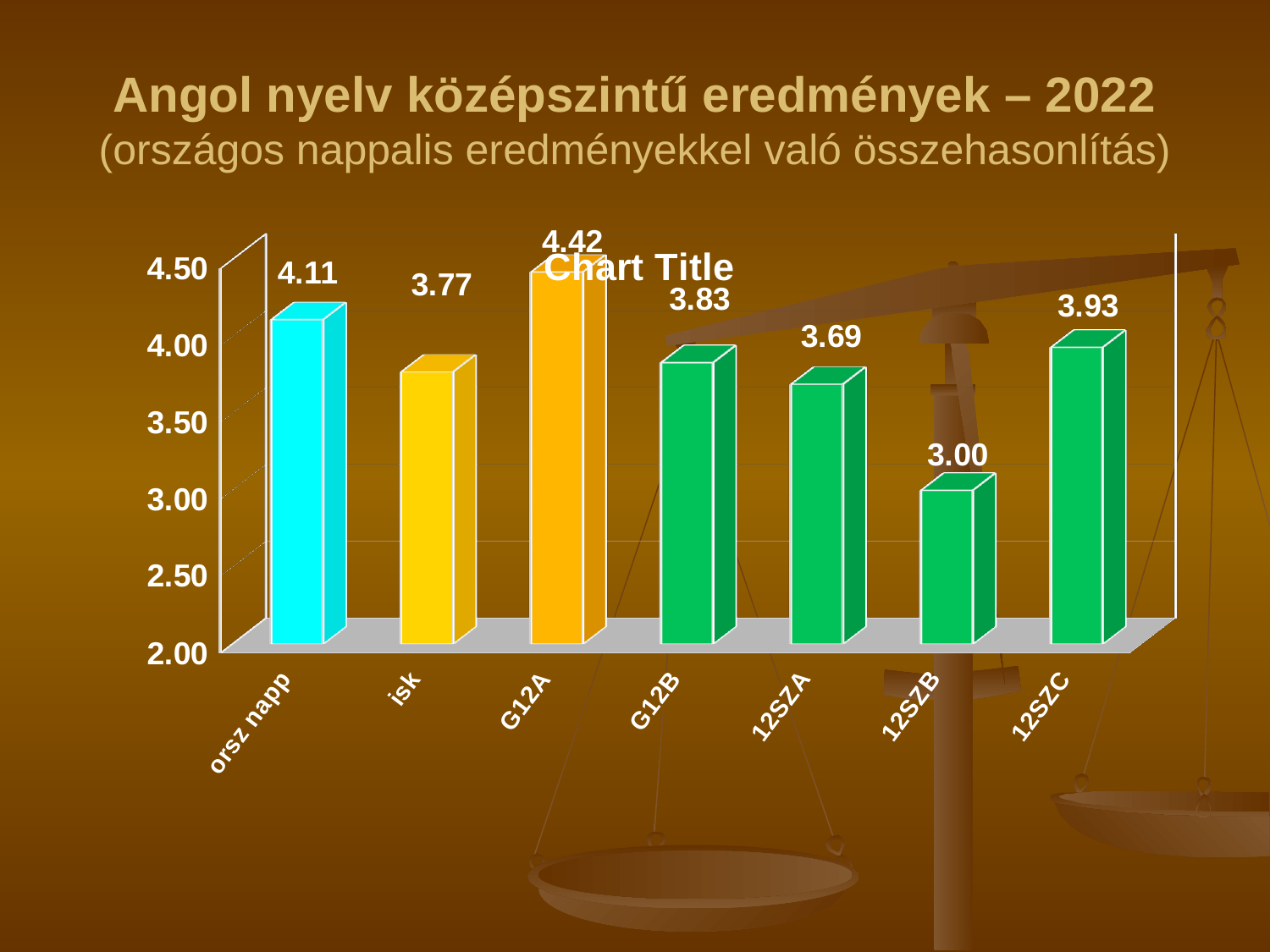
What kind of chart is shown on the slide? bar chart Which category has the highest value? G12A Which is larger, the value for 12SZC or the value for 12SZA? 12SZC What is the value for isk? 3.77 What is the value for orsz napp? 4.11 What is the title printed inside the chart area? Chart Title What is the difference between the values for G12A and 12SZB? 1.42 What is the value for 12SZB? 3.00 What is the value for G12A? 4.42 Which category has the lowest value? 12SZB What is the difference between the values for orsz napp and isk? 0.34 How many categories are shown on the x axis? 7